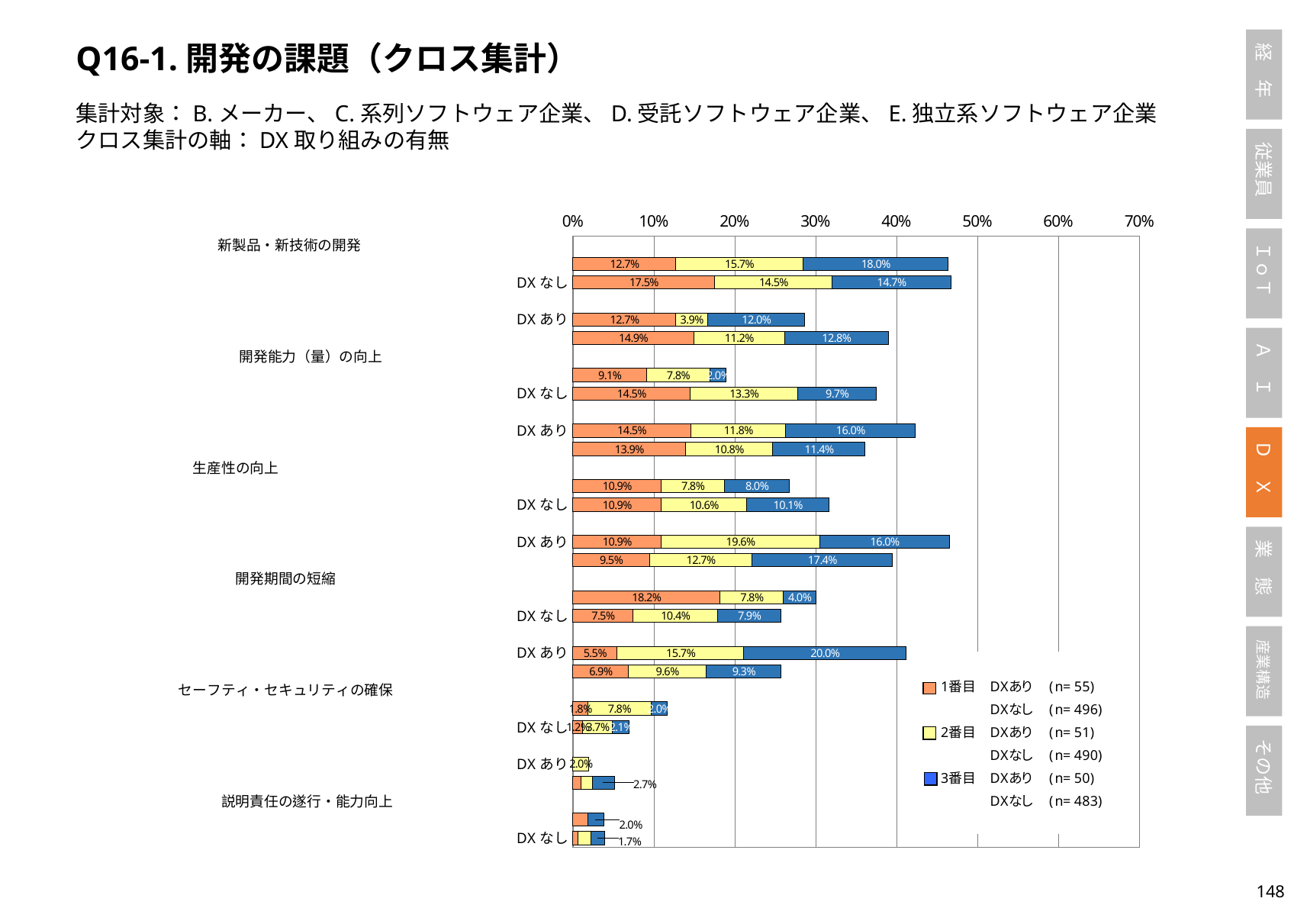
What are the three series names in the legend? 1番目, 2番目, 3番目 How many series does the legend list? 3 What kind of chart is shown on the slide? stacked bar chart In the topmost bar of the chart, what is the value of the 3番目 segment? 18.0% In the second bar from the top, what is the value of the 1番目 segment? 17.5% According to the legend, what is n for 1番目 DXあり? 55 In the bar whose 1番目 segment is 5.5%, what is the value of the 3番目 segment? 20.0% What is the total of the topmost bar (12.7%, 15.7%, 18.0%)? 46.4% Is the total of the topmost bar greater or less than 40%? greater In the topmost bar of the chart, which is larger, the 1番目 segment or the 2番目 segment? 2番目 What is the total of the bar with segments 5.5%, 15.7% and 20.0%? 41.2% In the topmost bar of the chart, what is the difference between the 2番目 segment (15.7%) and the 1番目 segment (12.7%)? 3.0%